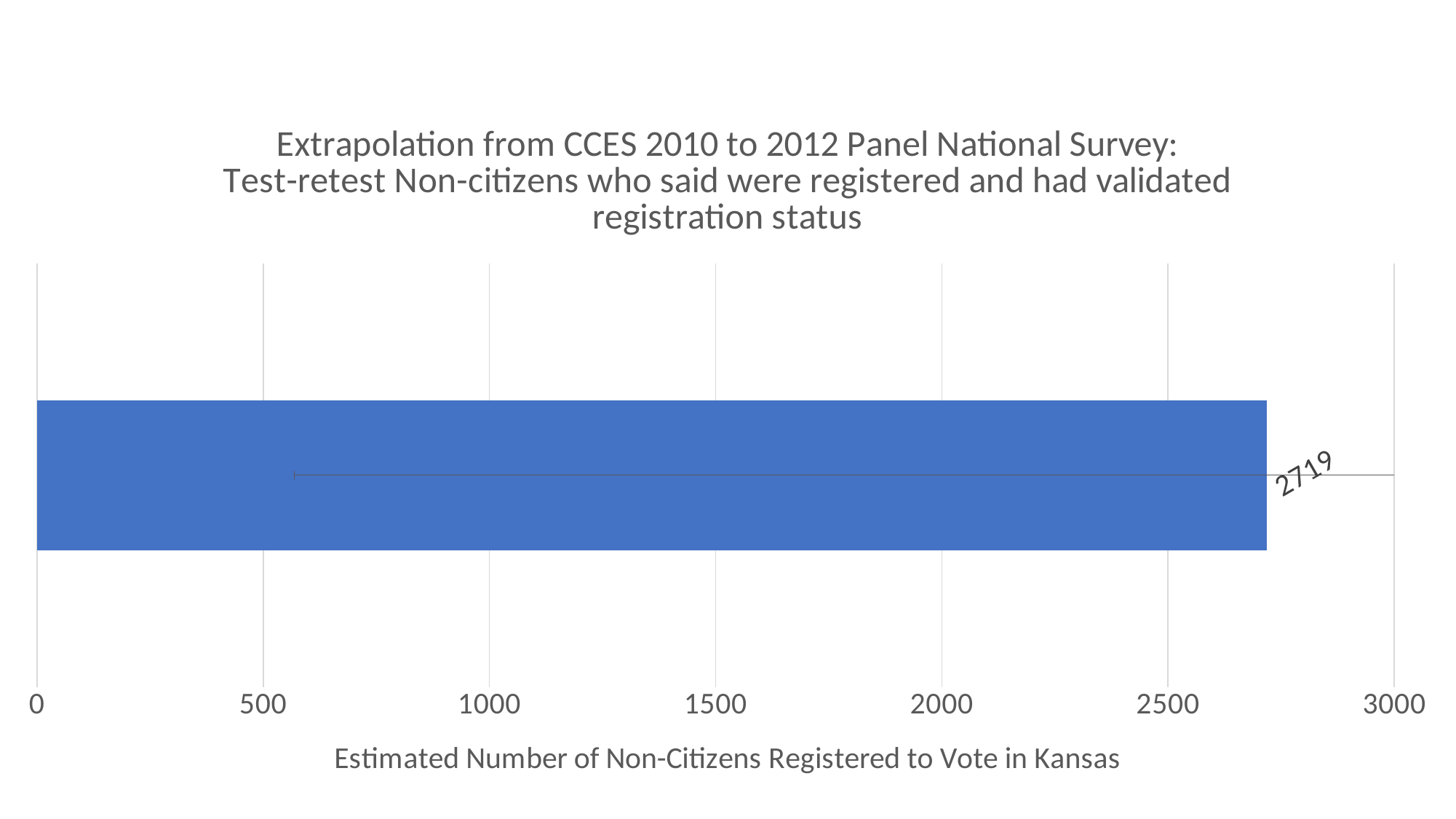
Is the value of the bar greater or less than 3000? less What kind of chart is shown on the slide? bar chart Is the bar in the chart oriented horizontally or vertically? horizontally What is the label of the horizontal axis? Estimated Number of Non-Citizens Registered to Vote in Kansas What is the maximum value shown on the horizontal axis? 3000 Is the value of the bar greater or less than 2500? greater What value is shown by the data label on the bar? 2719 How many bars are plotted in the chart? 1